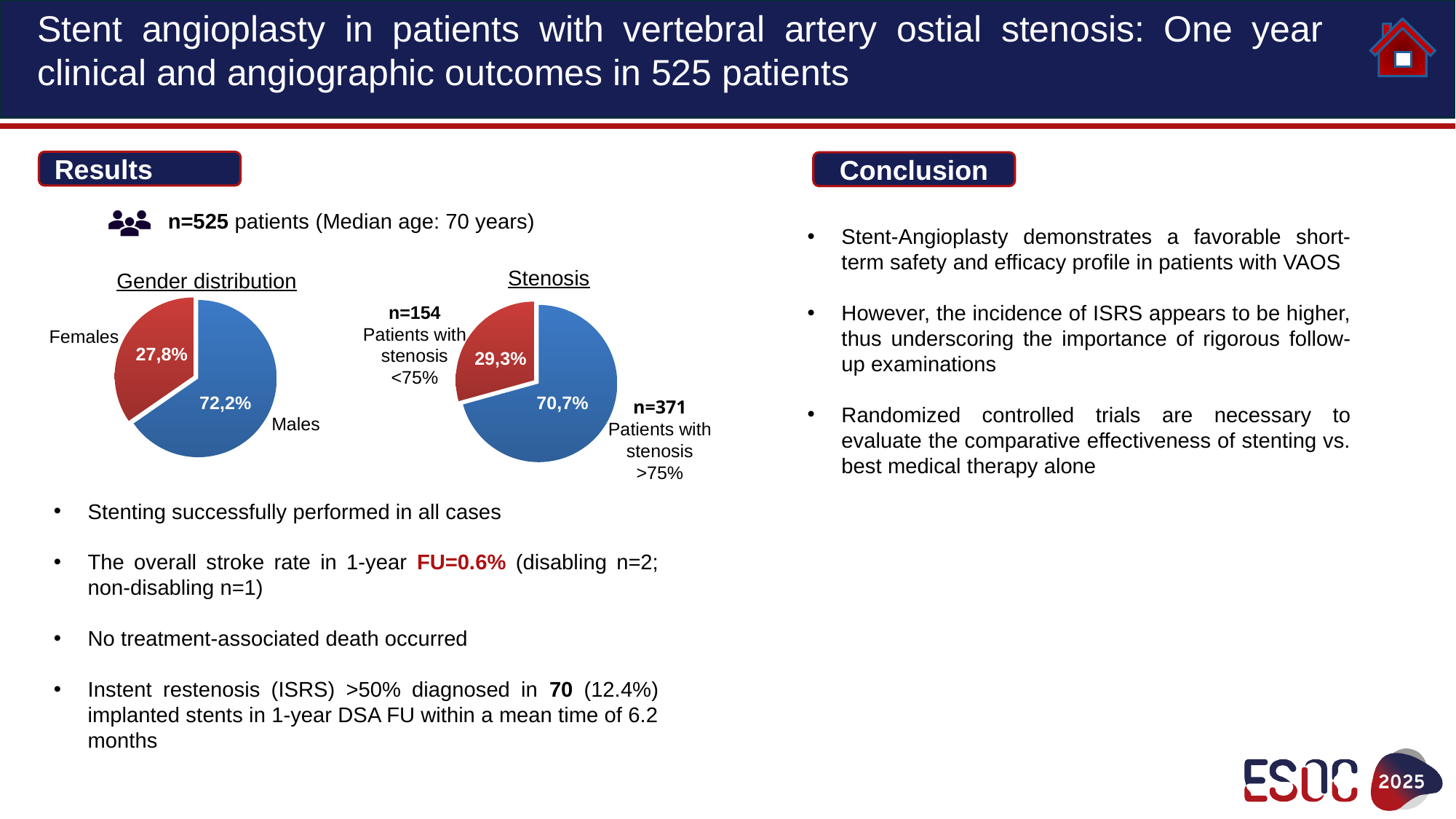
In the Stenosis chart, what percentage of patients have stenosis <75%? 29,3% In the Gender distribution chart, what percentage of patients are Females? 27,8% What kind of chart is the Gender distribution chart? Pie chart In the Stenosis chart, what colour is the slice for patients with stenosis >75%? Blue In the Stenosis chart, what percentage of patients have stenosis >75%? 70,7% In the Gender distribution chart, what is the difference in percentage points between Males and Females? 44,4 In the Gender distribution chart, what percentage of patients are Males? 72,2% In the Stenosis chart, how many patients have stenosis <75%? n=154 In the Gender distribution chart, which category has the larger share? Males In the Stenosis chart, how many patients have stenosis >75%? n=371 In the Stenosis chart, which group is smaller: patients with stenosis <75% or patients with stenosis >75%? Patients with stenosis <75% How many slices does the Gender distribution pie chart have? 2